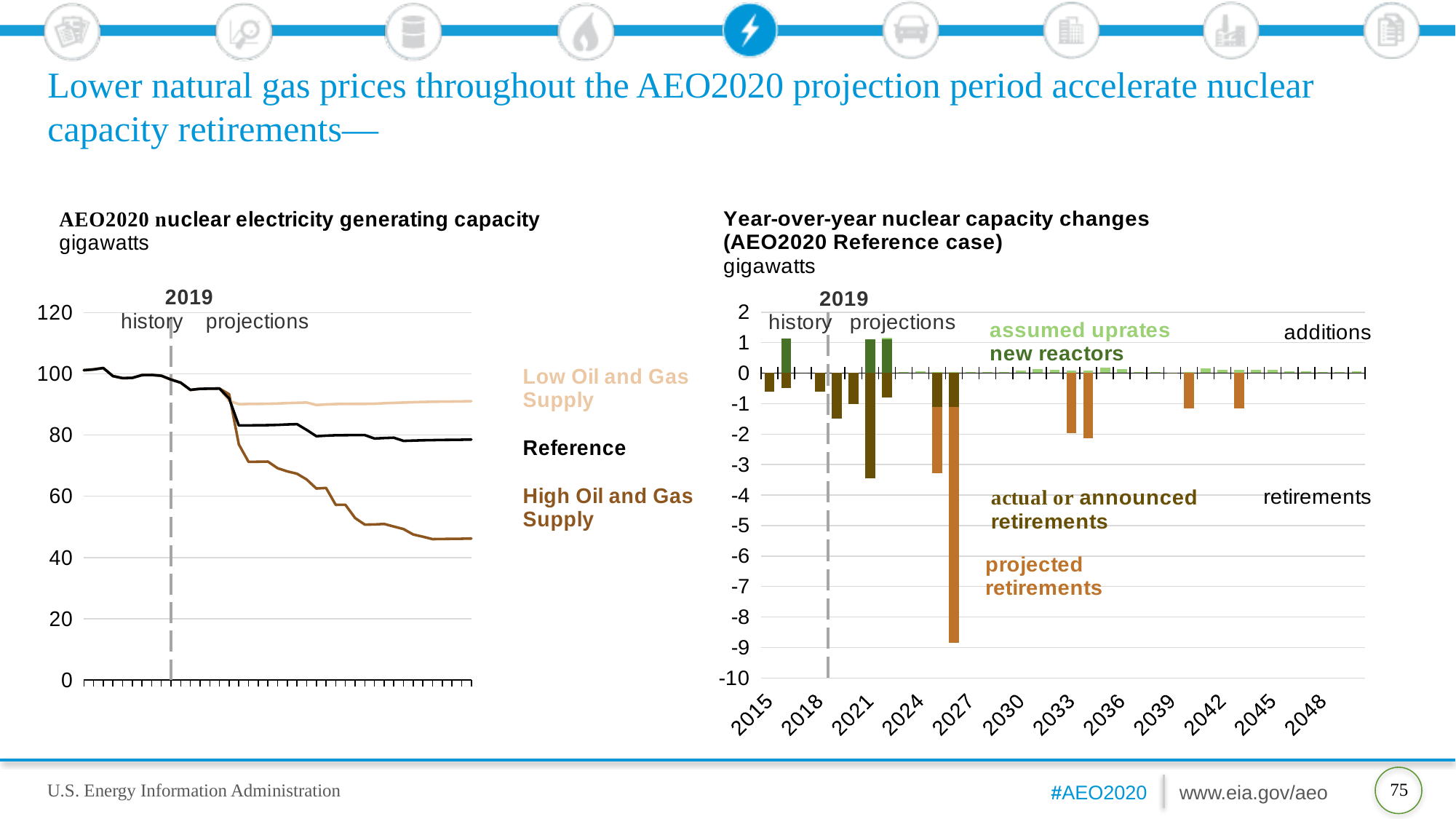
In the left chart, which series is higher at the end of the projection period, Low Oil and Gas Supply or High Oil and Gas Supply? Low Oil and Gas Supply In the left chart, does the High Oil and Gas Supply line rise or fall over the projection period? fall How many year labels are shown on the x axis of the right chart, 'Year-over-year nuclear capacity changes'? 12 In the left chart, is the value of the High Oil and Gas Supply line at the end of the projection period greater or less than 60? less How many series are shown in the left chart, 'AEO2020 nuclear electricity generating capacity'? 3 In the left chart, is the value of the Low Oil and Gas Supply line at the end of the projection period greater or less than 80? greater What unit is used on the y axis of both charts on the slide? gigawatts What kind of chart is the left chart, 'AEO2020 nuclear electricity generating capacity'? line chart In the left chart, which series has the lowest value at the end of the projection period? High Oil and Gas Supply How many series does the legend of the right chart, 'Year-over-year nuclear capacity changes', list? 4 What kind of chart is the right chart, 'Year-over-year nuclear capacity changes (AEO2020 Reference case)'? bar chart